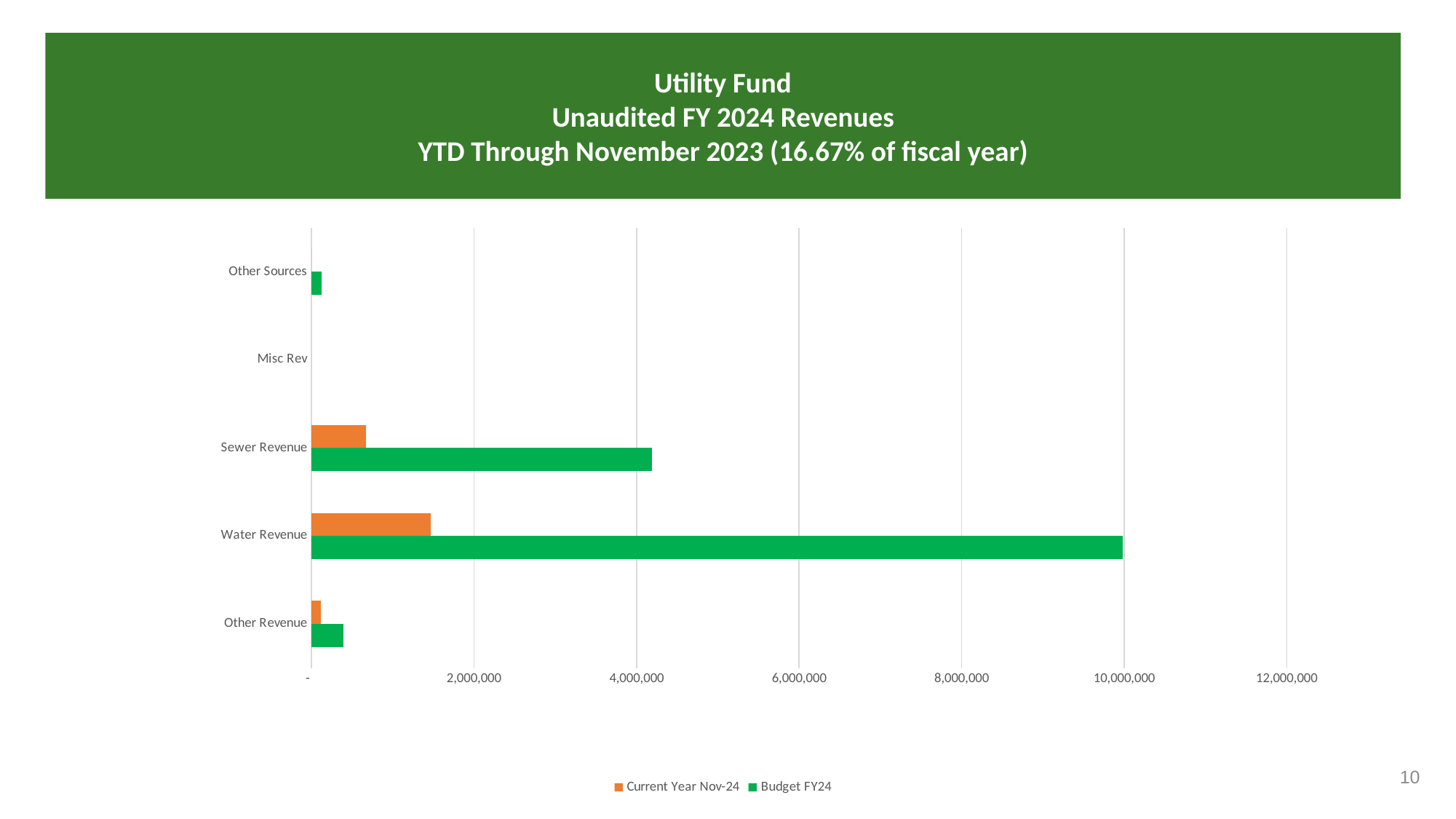
Is the Budget FY24 value for Sewer Revenue greater or less than 4,000,000? greater How many series does the legend list? 2 Which series is shown in orange? Current Year Nov-24 What kind of chart is shown on the slide? Bar chart How many categories are shown on the chart? 5 Is the Budget FY24 value for Water Revenue greater or less than 8,000,000? greater Which category has the highest Budget FY24 value? Water Revenue Which category has the highest Current Year Nov-24 value? Water Revenue Which is larger, the Budget FY24 value for Water Revenue or for Sewer Revenue? Water Revenue Is the Current Year Nov-24 value for Water Revenue greater or less than 2,000,000? less What is the title of the chart? Utility Fund Unaudited FY 2024 Revenues YTD Through November 2023 (16.67% of fiscal year)